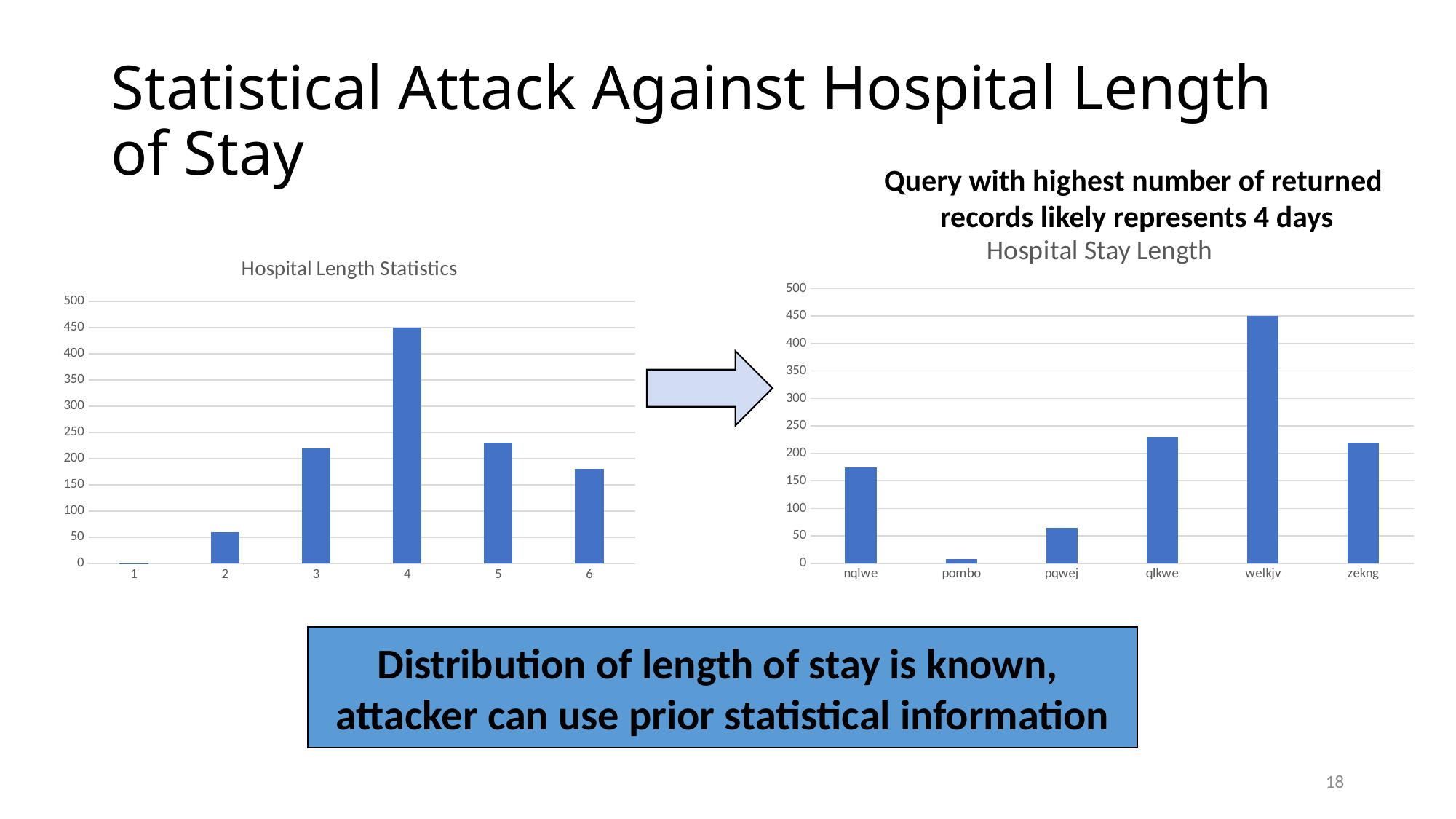
In the 'Hospital Length Statistics' chart, is the value for category 3 greater or less than 200? greater In the 'Hospital Stay Length' chart, which is larger, the value for nqlwe or zekng? zekng In the 'Hospital Length Statistics' chart, which category has the lowest value? 1 What type of chart is the 'Hospital Length Statistics' chart? bar chart In the 'Hospital Stay Length' chart, is the value for pqwej greater or less than 100? less In the 'Hospital Length Statistics' chart, which is larger, the value for category 5 or category 6? 5 How many categories are shown on the x axis of the 'Hospital Length Statistics' chart? 6 In the 'Hospital Length Statistics' chart, is the value for category 2 greater or less than 100? less In the 'Hospital Length Statistics' chart, which category has the highest value? 4 In the 'Hospital Stay Length' chart, which category has the highest value? welkjv In the 'Hospital Stay Length' chart, which category has the lowest value? pombo What is the title of the chart on the right side of the slide? Hospital Stay Length